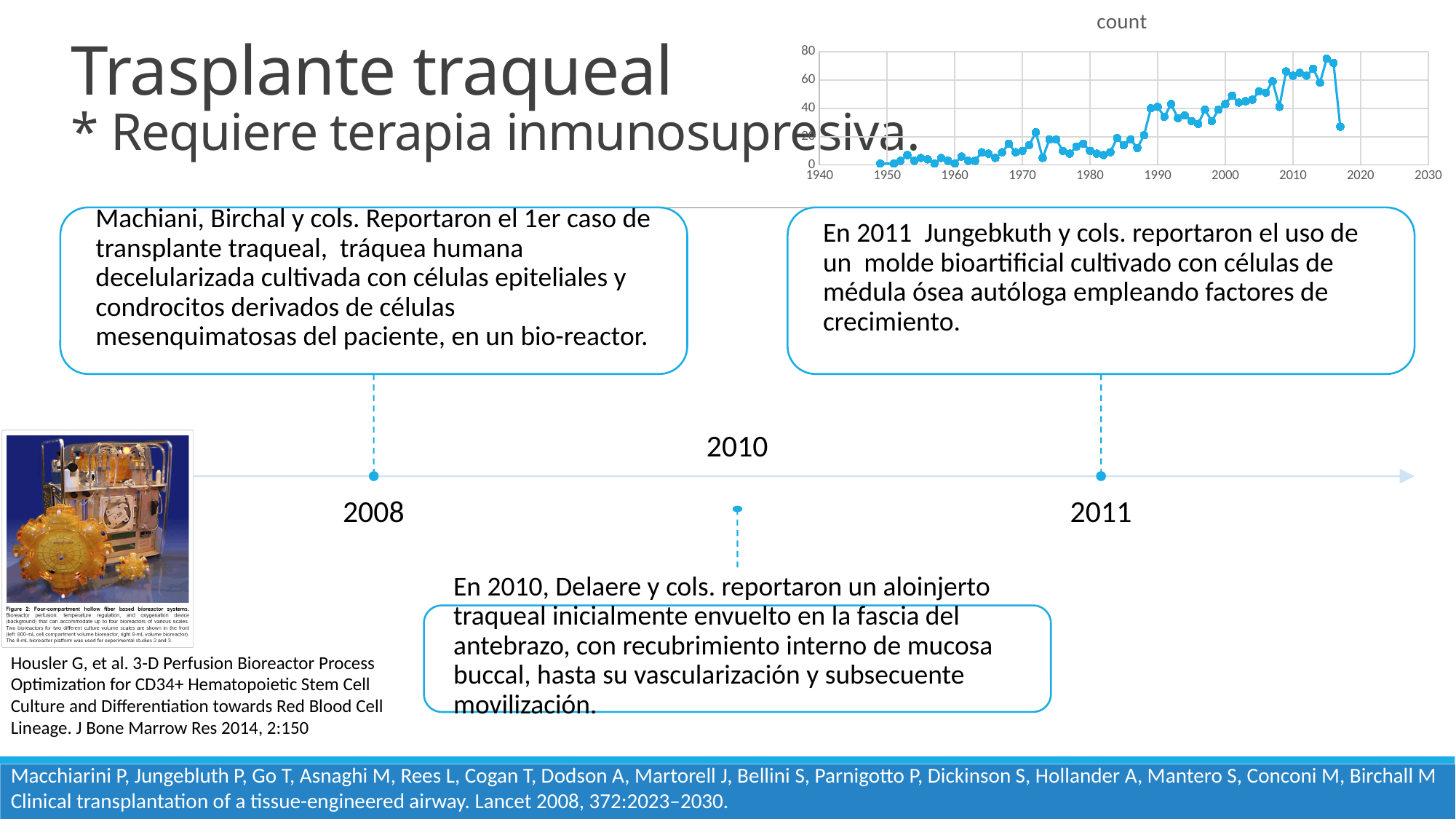
Is the value plotted around 1950 greater or less than 20? less In roughly which decade does the chart reach its highest value? the 2010s Overall, do the values in the chart rise or fall from 1950 to 2015? rise Is the value plotted around 1980 greater or less than 20? less Is the value plotted around 2010 greater or less than 40? greater What is the title of the chart in the top right of the slide? count How many lines (series) are plotted in the chart? 1 What is the highest value shown on the chart's vertical axis? 80 Which is larger in the chart: the value around 1960 or the value around 2010? the value around 2010 What kind of chart is shown in the top right of the slide? line chart